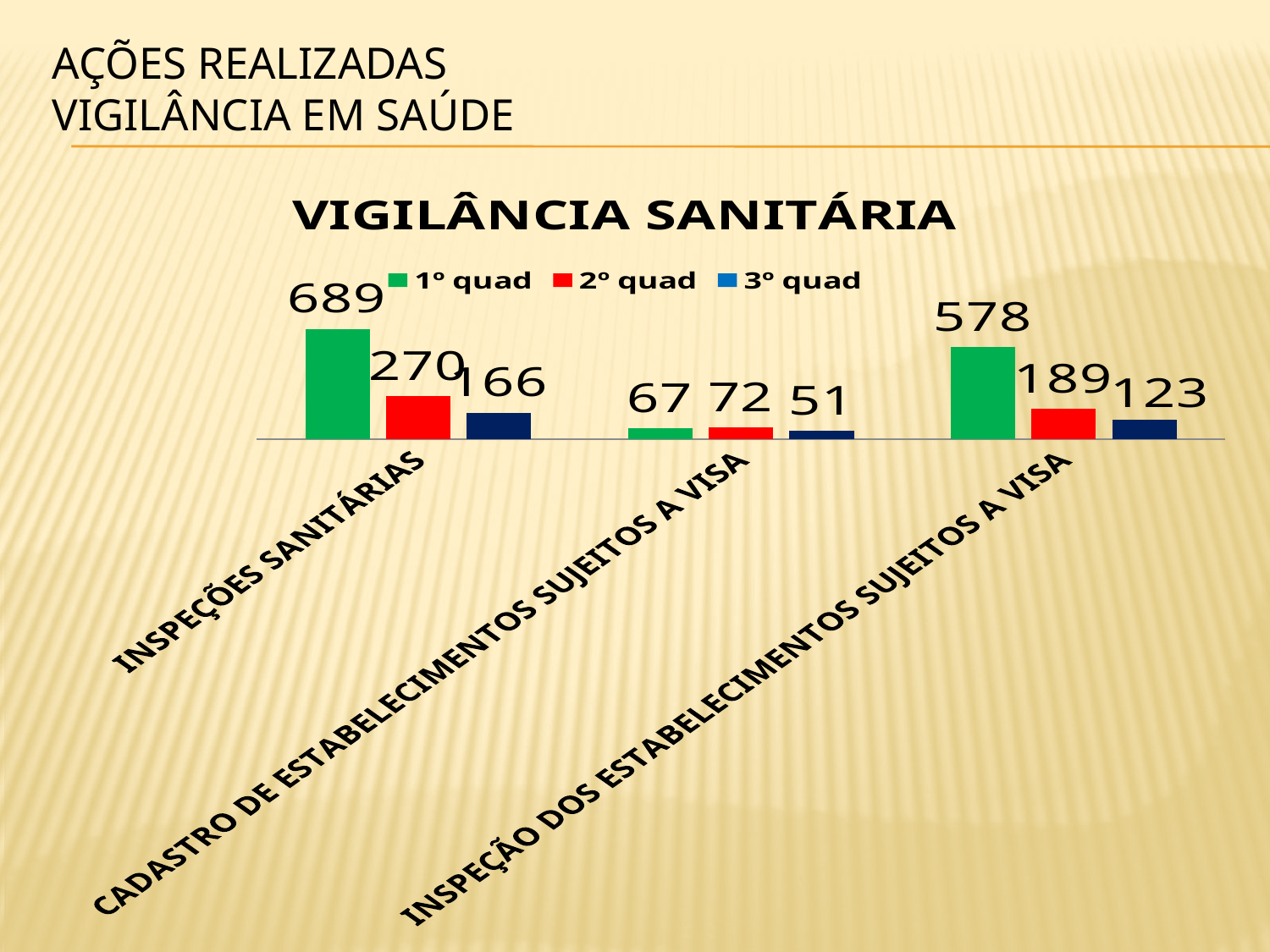
How many series does the legend list? 3 What is the value for 2º quad in the CADASTRO DE ESTABELECIMENTOS SUJEITOS A VISA category? 72 What is the difference between the 1º quad and 2º quad values for INSPEÇÕES SANITÁRIAS? 419 What is the value for 1º quad in the INSPEÇÕES SANITÁRIAS category? 689 Which category has the lowest 3º quad value? CADASTRO DE ESTABELECIMENTOS SUJEITOS A VISA Which is larger for CADASTRO DE ESTABELECIMENTOS SUJEITOS A VISA: the 1º quad value or the 2º quad value? 2º quad What kind of chart is shown? bar chart Which category has the highest 1º quad value? INSPEÇÕES SANITÁRIAS What is the difference between the 2º quad and 3º quad values for INSPEÇÃO DOS ESTABELECIMENTOS SUJEITOS A VISA? 66 What is the title of the chart? VIGILÂNCIA SANITÁRIA What is the value for 3º quad in the INSPEÇÃO DOS ESTABELECIMENTOS SUJEITOS A VISA category? 123 How many categories are shown on the x axis? 3